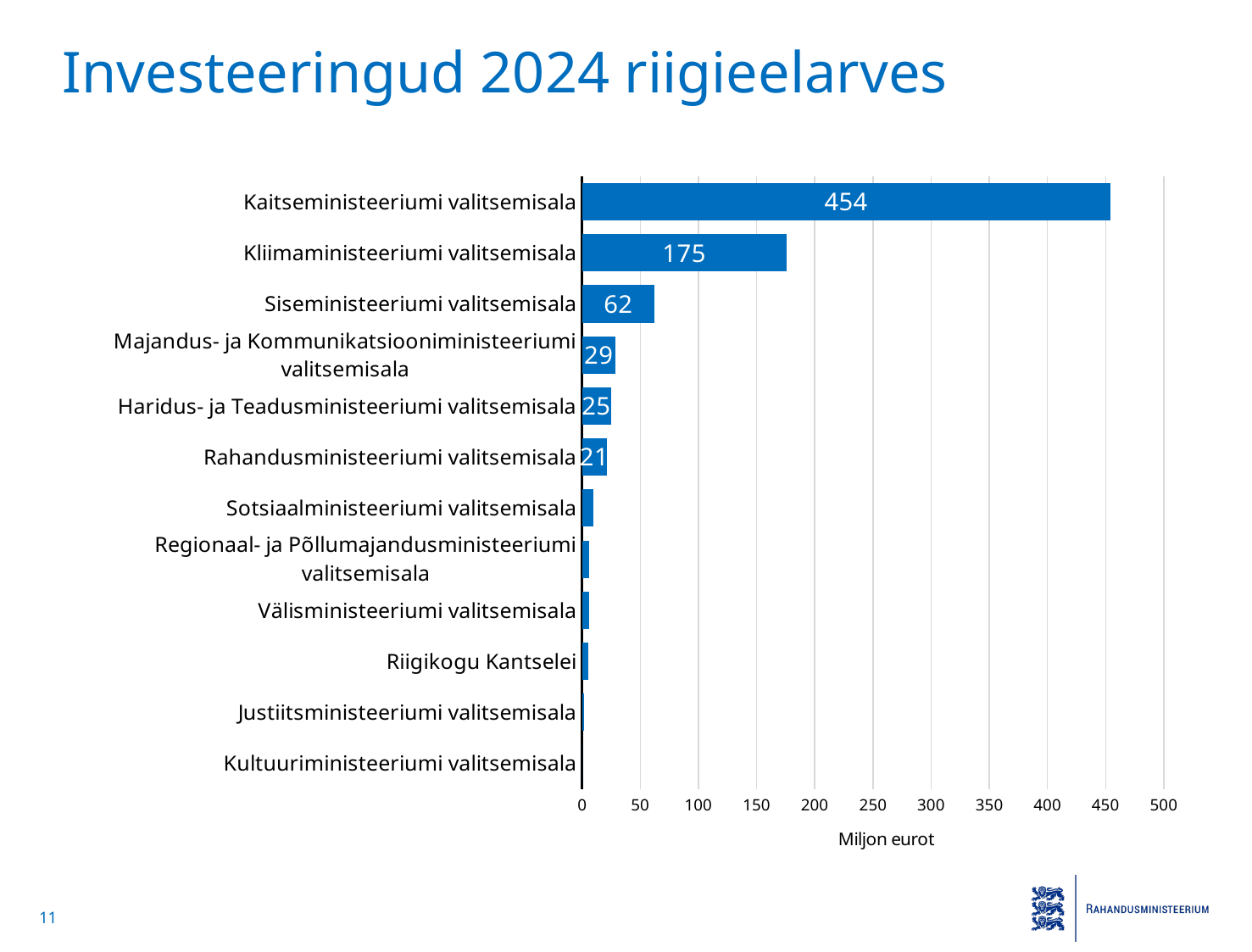
What is the value for Kaitseministeeriumi valitsemisala? 454 Is the value for Kliimaministeeriumi valitsemisala greater or less than 150? greater Which is larger, the value for Majandus- ja Kommunikatsiooniministeeriumi valitsemisala or the value for Rahandusministeeriumi valitsemisala? Majandus- ja Kommunikatsiooniministeeriumi valitsemisala What is the label of the horizontal axis? Miljon eurot Which category has the highest value? Kaitseministeeriumi valitsemisala What kind of chart is shown on the slide? bar chart What is the value for Kliimaministeeriumi valitsemisala? 175 What is the value for Siseministeeriumi valitsemisala? 62 How many categories are shown in the chart? 12 Is the value for Sotsiaalministeeriumi valitsemisala greater or less than 50? less What is the difference between the values for Kaitseministeeriumi valitsemisala and Kliimaministeeriumi valitsemisala? 279 What is the value for Haridus- ja Teadusministeeriumi valitsemisala? 25